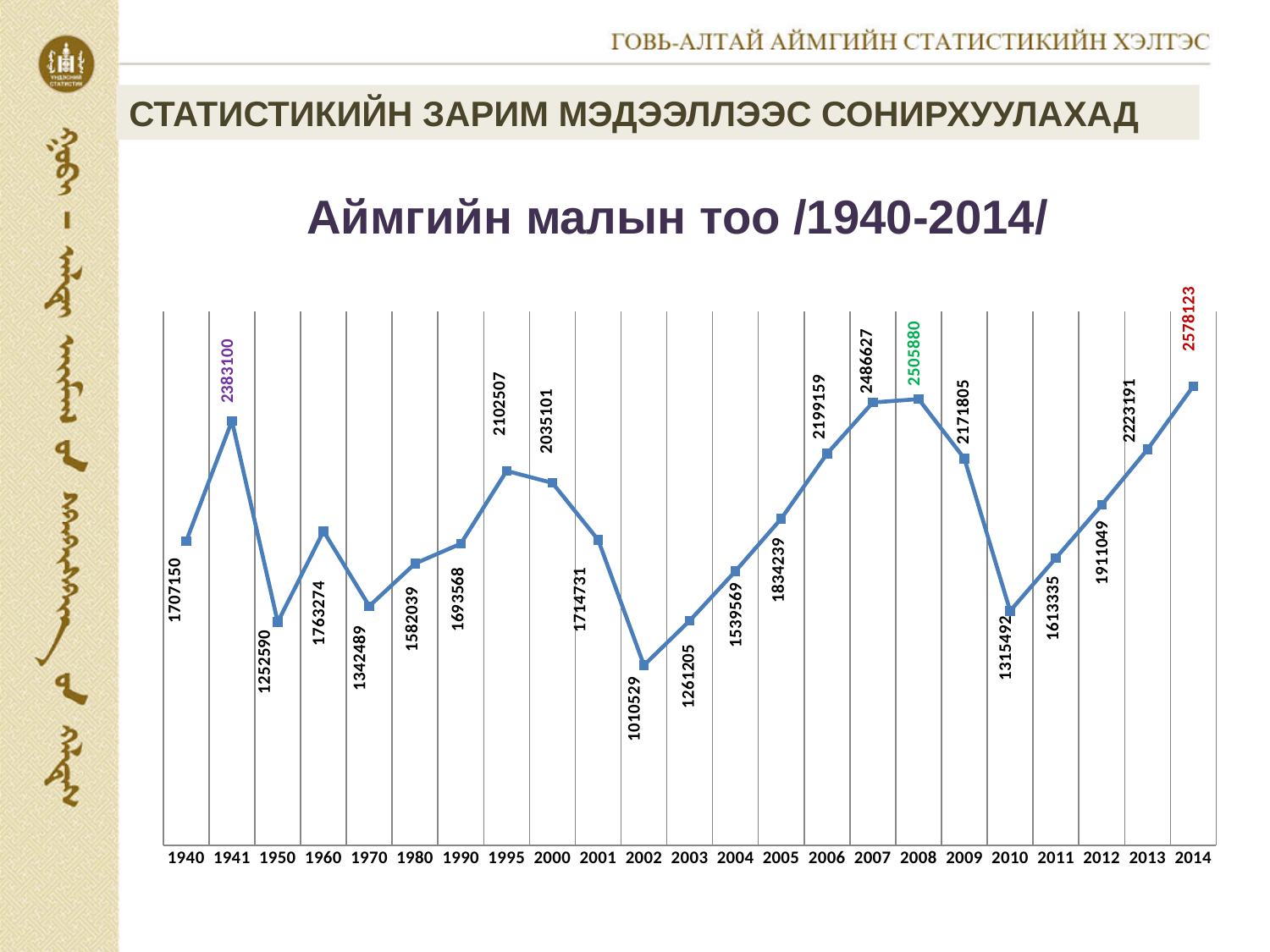
What is the value for 2008 in the chart? 2505880 What is the value for 1940 in the chart "Аймгийн малын тоо /1940-2014/"? 1707150 How many years are plotted in the chart? 23 What kind of chart is shown on the slide? line chart Which year has the highest value in the chart? 2014 What is the difference between the values for 2014 and 2008? 72243 Do the values rise or fall from 2010 to 2014? rise Which is larger, the value for 1941 or the value for 2007? 2007 Which year has the lowest value in the chart? 2002 What is the value for 2002 in the chart? 1010529 What is the value for 2014 in the chart? 2578123 What is the difference between the values for 2011 and 2010? 297843